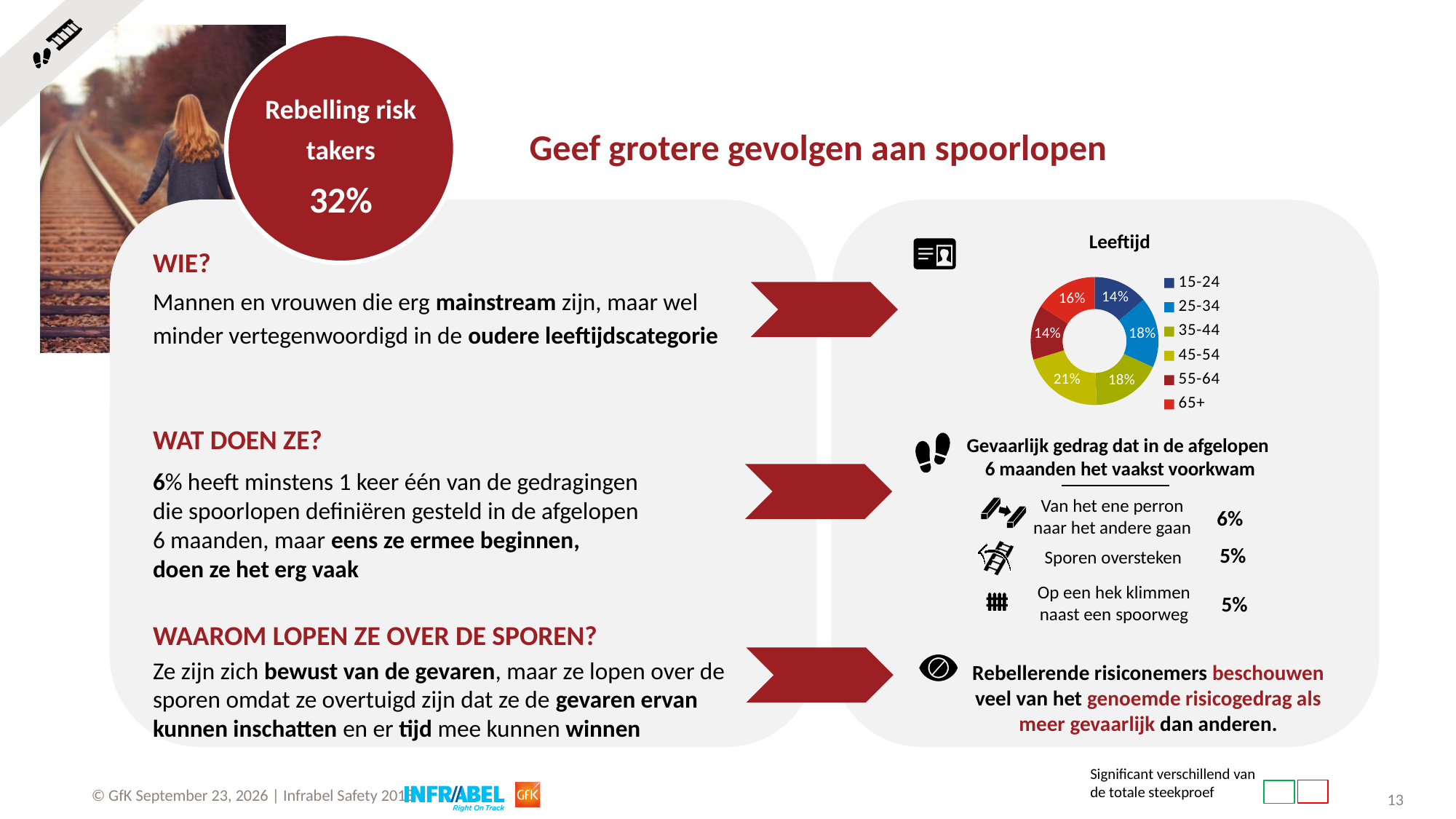
Which age group has the largest share in the 'Leeftijd' chart? 45-54 In the 'Leeftijd' chart, what percentage is shown for the 55-64 age group? 14% In the 'Leeftijd' chart, what percentage is shown for the 15-24 age group? 14% In the 'Leeftijd' chart, what percentage is shown for the 65+ age group? 16% In the 'Leeftijd' chart, what is the combined share of the 25-34 and 35-44 age groups? 36% In the 'Leeftijd' chart, what percentage is shown for the 25-34 age group? 18% In the 'Leeftijd' chart, what percentage is shown for the 45-54 age group? 21% In the 'Leeftijd' chart, what is the difference between the shares of the 45-54 and 65+ age groups? 5% In the 'Leeftijd' chart, which has a larger share: 65+ or 55-64? 65+ What type of chart is the 'Leeftijd' chart? doughnut chart What is the title of the doughnut chart on the slide? Leeftijd How many age groups are shown in the 'Leeftijd' chart? 6